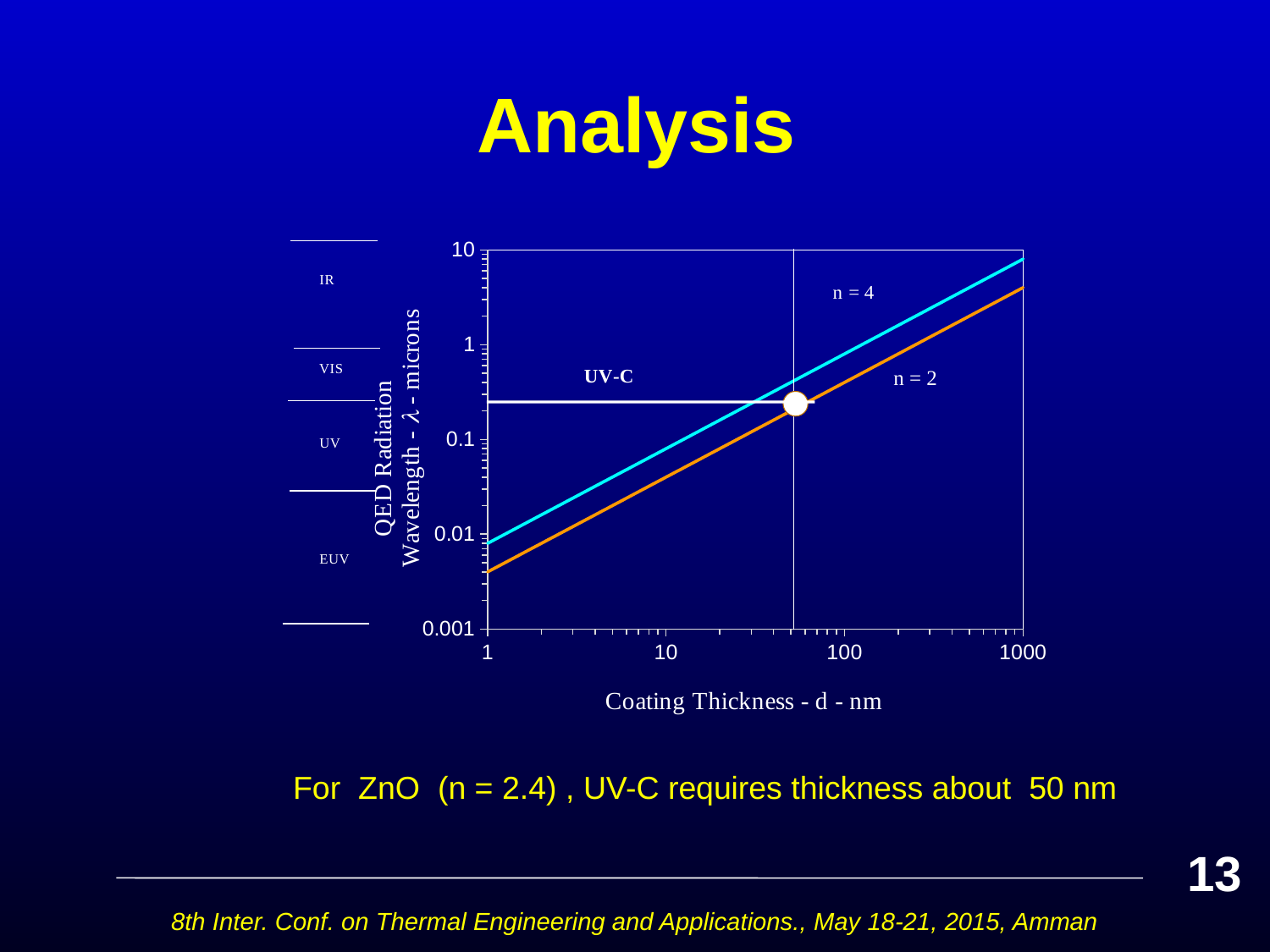
How many lines are plotted on the chart? 2 What is the title of the x axis of the chart? Coating Thickness - d - nm Is the wavelength for the n = 2 line at a coating thickness of 1 nm greater or less than 0.01 microns? less What is the smallest value shown on the y axis of the chart? 0.001 Is the wavelength for the n = 2 line at a coating thickness of 1000 nm greater or less than 1 micron? greater What kind of chart is shown on the slide? line chart What is the largest value shown on the x axis of the chart? 1000 What is the title of the y axis of the chart? QED Radiation Wavelength - λ - microns Do the plotted lines rise or fall as coating thickness increases? rise Which line lies higher on the chart, n = 4 or n = 2? n = 4 Is the wavelength for the n = 4 line at a coating thickness of 10 nm greater or less than 0.1 microns? less